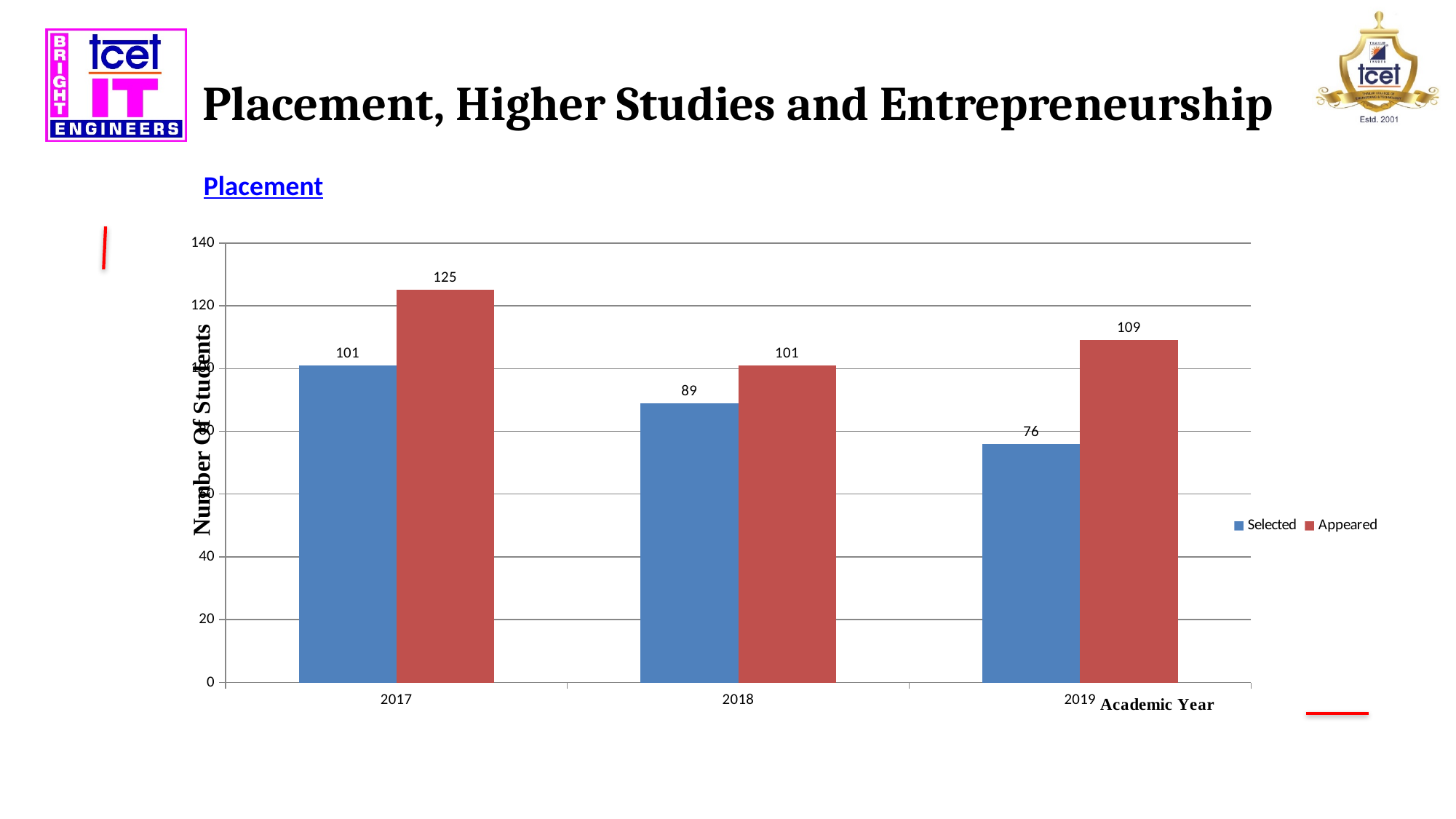
In which academic year was the number of students Appeared the highest? 2017 Does the number of students Selected rise or fall from 2017 to 2019? fall In which academic year was the number of students Selected the lowest? 2019 Which is larger: the number Selected in 2017 or the number Appeared in 2019? Appeared in 2019 How many academic years are shown on the x axis? 3 How many series does the legend list? 2 What is the difference between the number of students Appeared and Selected in 2018? 12 Is the number of students Appeared in 2017 greater or less than 120? greater How many students Appeared in 2019? 109 How many students were Selected in 2017? 101 What is the difference between the number of students Appeared in 2017 and in 2019? 16 How many students were Selected in 2018? 89